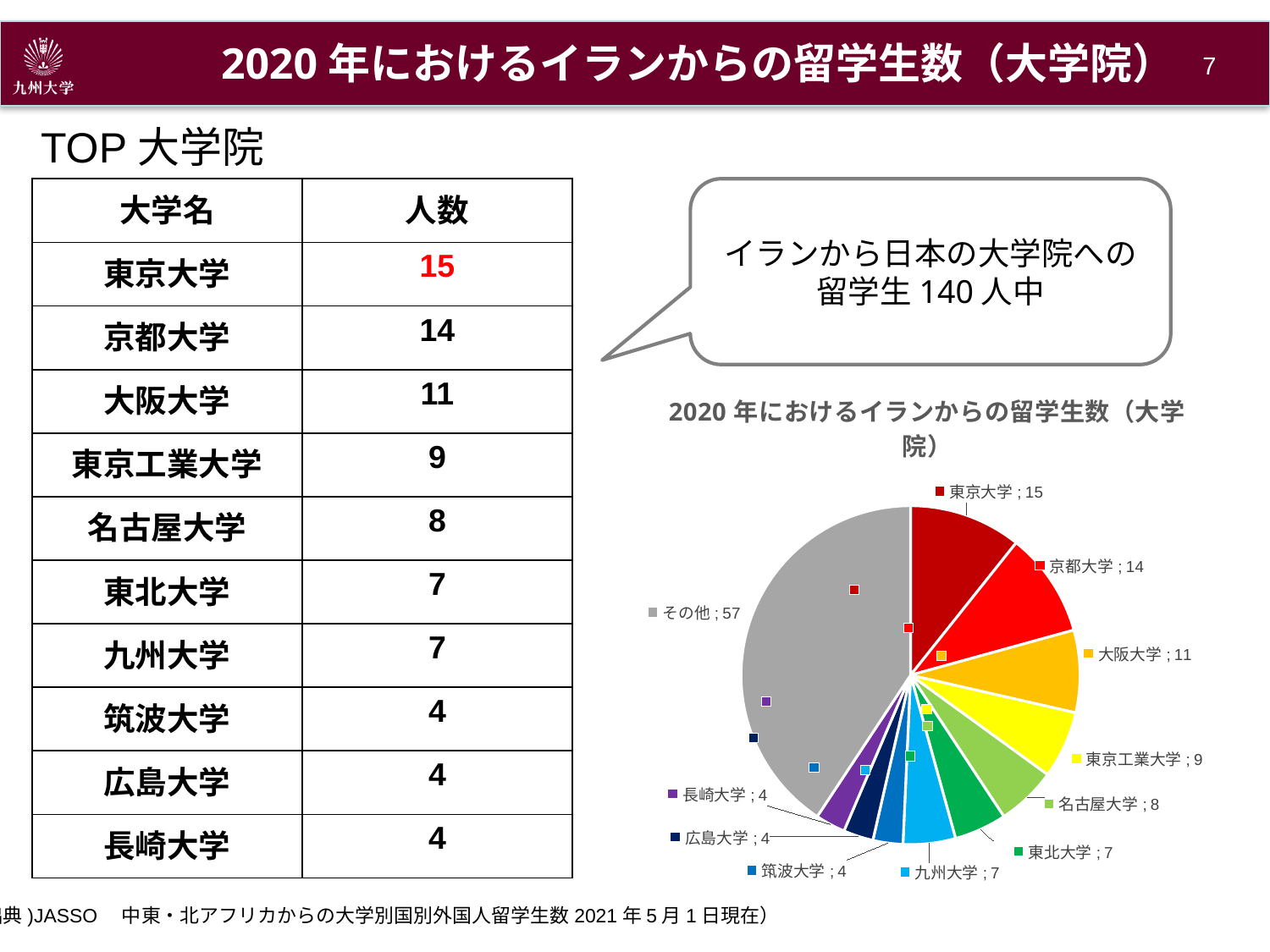
What is the difference between the values for 東京大学 and 京都大学 in the pie chart? 1 In the pie chart, what is the value for 名古屋大学? 8 In the pie chart, what is the value for 大阪大学? 11 What type of chart is shown on the slide? Pie chart What is the difference between the values for その他 and 大阪大学 in the pie chart? 46 How many slices does the pie chart have? 11 What is the title of the pie chart? 2020年におけるイランからの留学生数（大学院） In the pie chart, what is the value for 東京大学? 15 In the pie chart, what is the value for その他? 57 Among the named universities in the pie chart (excluding その他), which has the highest value? 東京大学 In the pie chart, which is larger: the value for 東京工業大学 or 東北大学? 東京工業大学 Which slice of the pie chart is the largest? その他